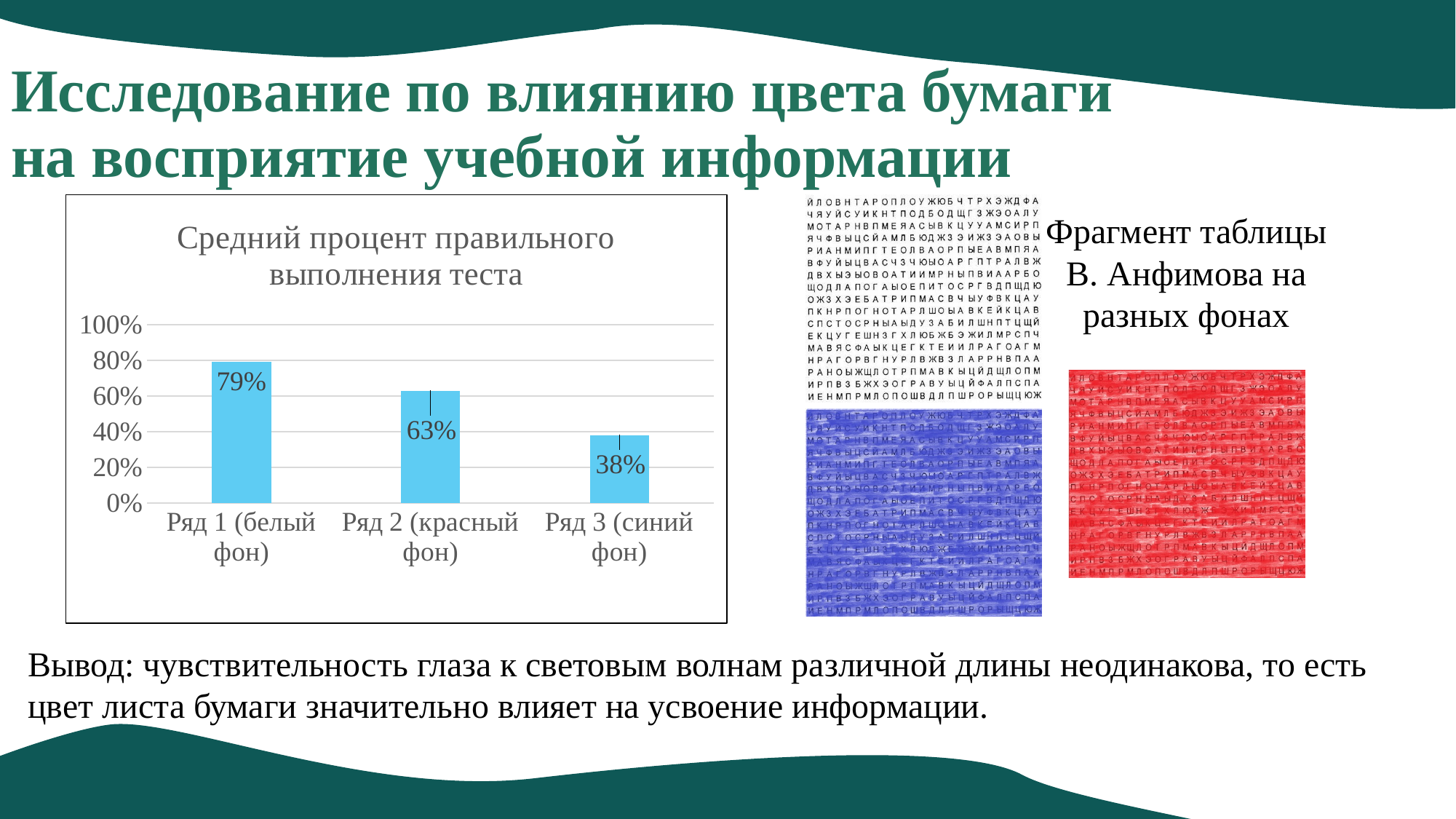
What is the title of the chart? Средний процент правильного выполнения теста What is the value for Ряд 2 (красный фон)? 63% How many categories are shown in the chart? 3 What is the difference between the values for Ряд 1 (белый фон) and Ряд 2 (красный фон)? 16% What is the value for Ряд 1 (белый фон)? 79% Is the value for Ряд 3 (синий фон) greater or less than 40%? less Which is larger, the value for Ряд 2 (красный фон) or Ряд 3 (синий фон)? Ряд 2 (красный фон) What kind of chart is shown on the slide? bar chart What is the value for Ряд 3 (синий фон)? 38% Which category has the highest value? Ряд 1 (белый фон) Which category has the lowest value? Ряд 3 (синий фон) What is the difference between the values for Ряд 1 (белый фон) and Ряд 3 (синий фон)? 41%